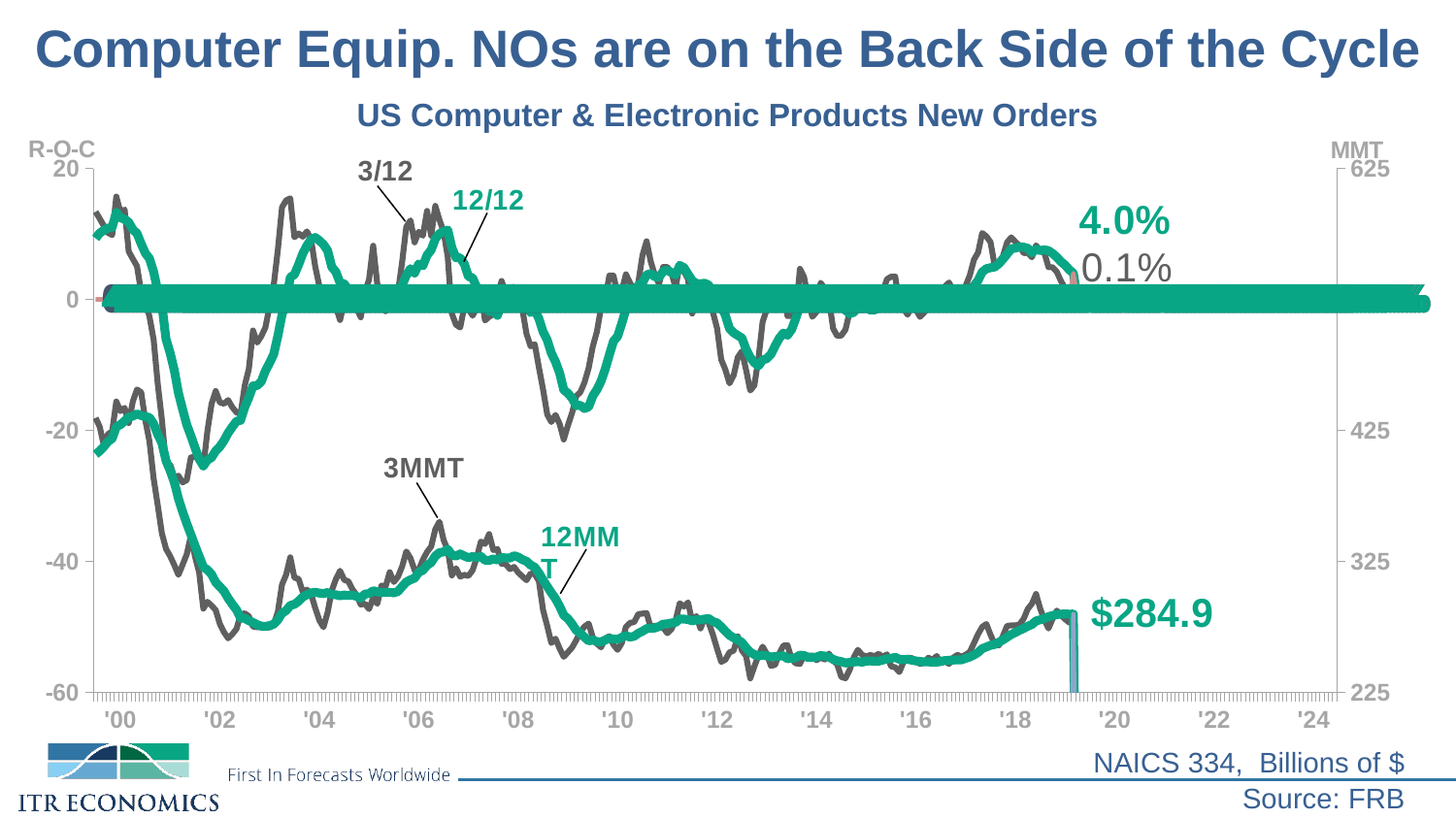
How many data series are labeled on the chart? 4 What is the label of the right-hand axis? MMT What is the latest value shown for the 12MMT series? $284.9 What is the latest value shown for the 12/12 rate-of-change series? 4.0% What is the difference between the latest 12/12 value (4.0%) and the latest 3/12 value (0.1%)? 3.9% What kind of chart is shown on the slide? line chart Which is larger at the end of the series, the 12/12 value or the 3/12 value? 12/12 Did the 12MMT series rise or fall between '00 and '02? fall What is the latest value shown for the 3/12 rate-of-change series? 0.1% Did the 12MMT series rise or fall between '16 and '18? rise Is the latest 12MMT value of $284.9 greater or less than 325 on the right axis? less What is the title of the chart? US Computer & Electronic Products New Orders